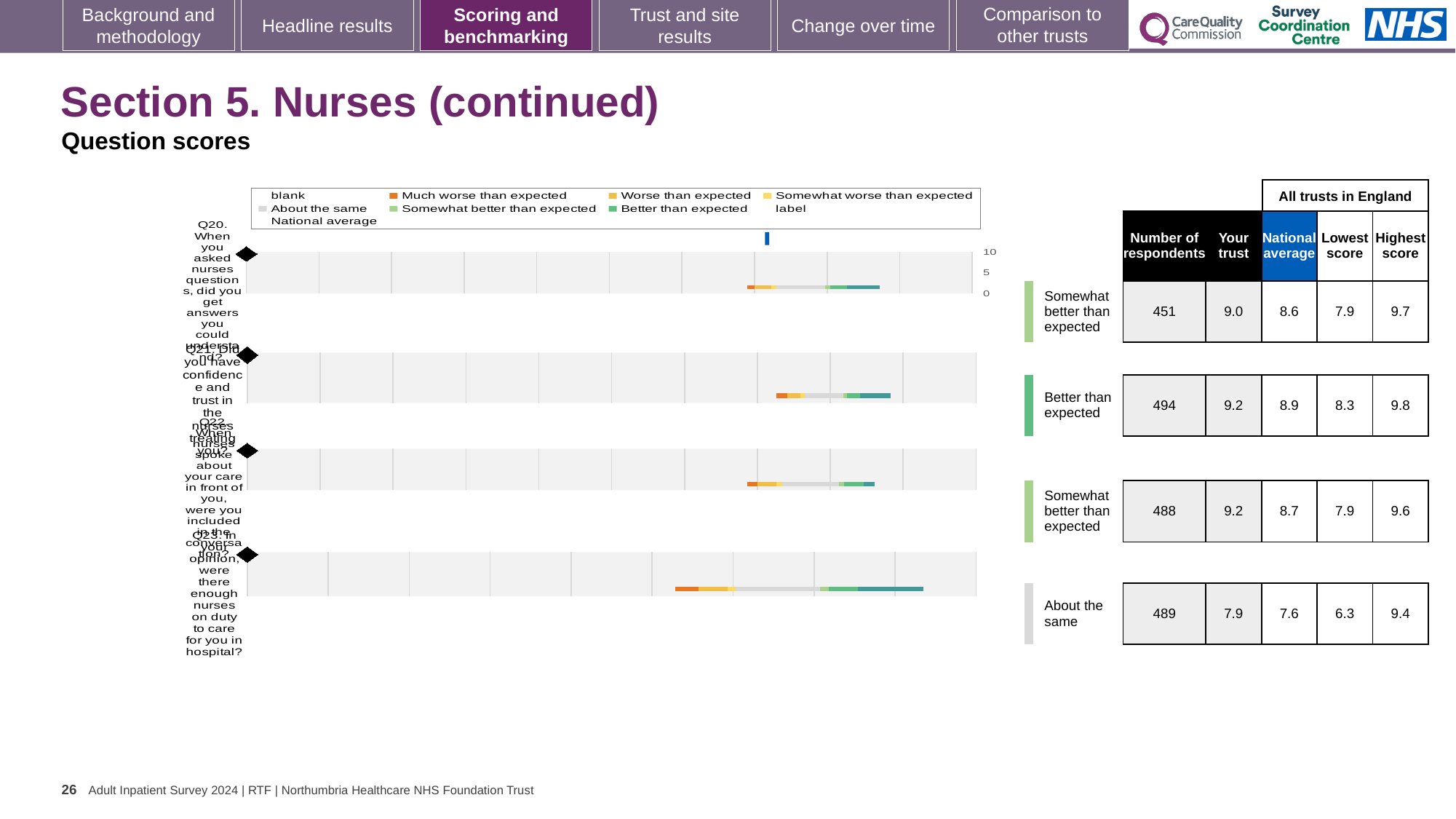
In the table beside the chart, which question has the lowest 'Your trust' score? Q23 In the table beside the chart, what is the highest score across all trusts in England for Q21? 9.8 In the table beside the chart, what is the 'Your trust' score for Q21 (confidence and trust in the nurses)? 9.2 What colour does the legend use for 'Much worse than expected'? orange In the table beside the chart, how many respondents answered Q20? 451 In the table beside the chart, what is the national average for Q23 (enough nurses on duty)? 7.6 In the table beside the chart, is the 'Your trust' score for Q20 larger or smaller than the national average for Q20? larger In the table beside the chart, what benchmark category is given for Q23? About the same What is the highest value shown on the chart's numeric axis? 10 In the table beside the chart, what is the difference between the highest score and the lowest score for Q22? 1.7 What kind of chart is shown on the slide? bar chart How many question rows (categories) are plotted in the chart? 4